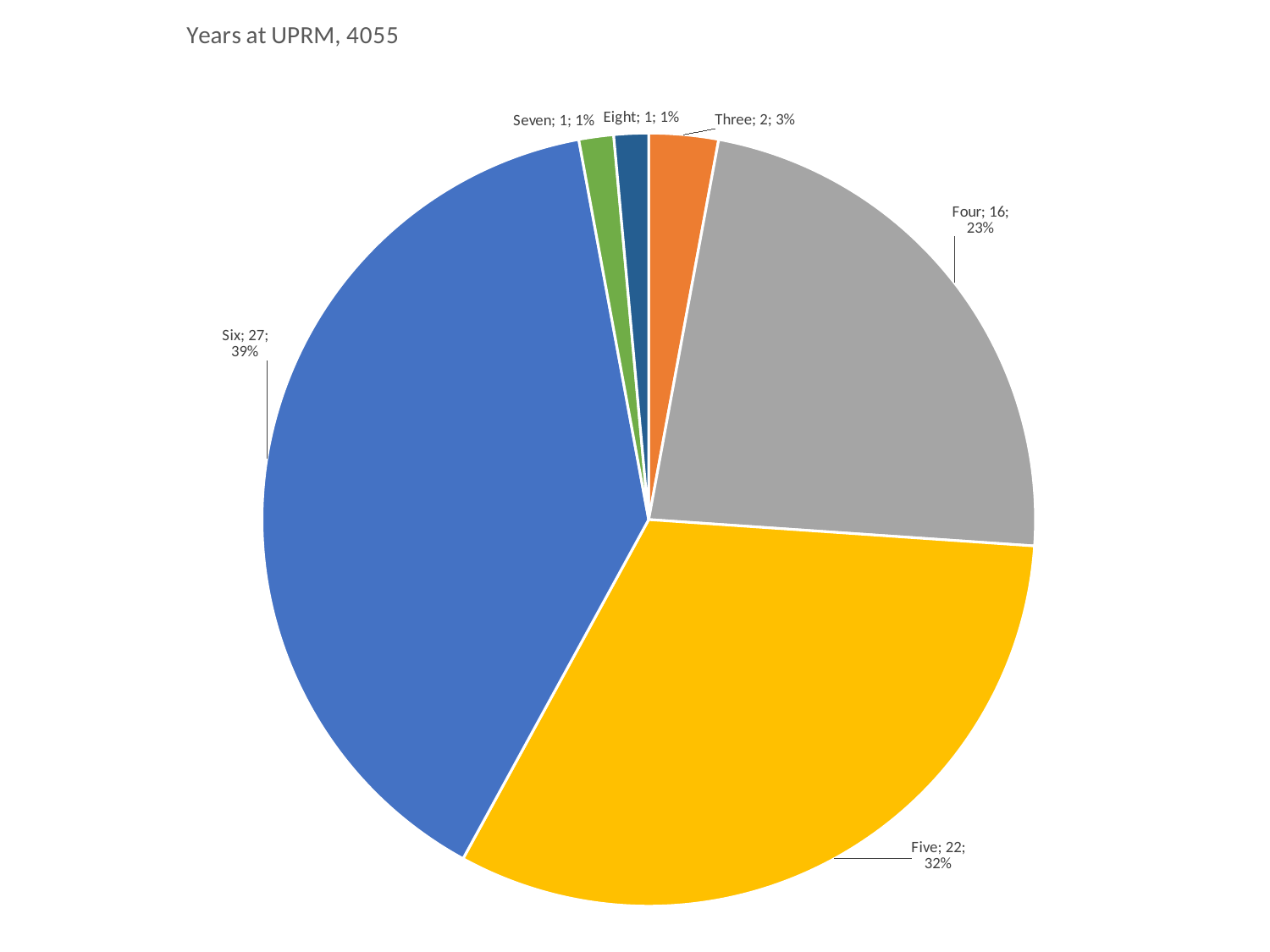
What share of the pie does Four represent? 23% What is the difference between the values for Six and Five? 5 What is the title of the chart? Years at UPRM, 4055 How many slices does the pie chart have? 6 What is the value for Six? 27 What is the value for Five? 22 What is the value for Four? 16 What kind of chart is shown on the slide? pie chart What is the value for Three? 2 What share of the pie does Five represent? 32% Which is larger, the value for Four or the value for Three? Four Which category has the largest slice? Six